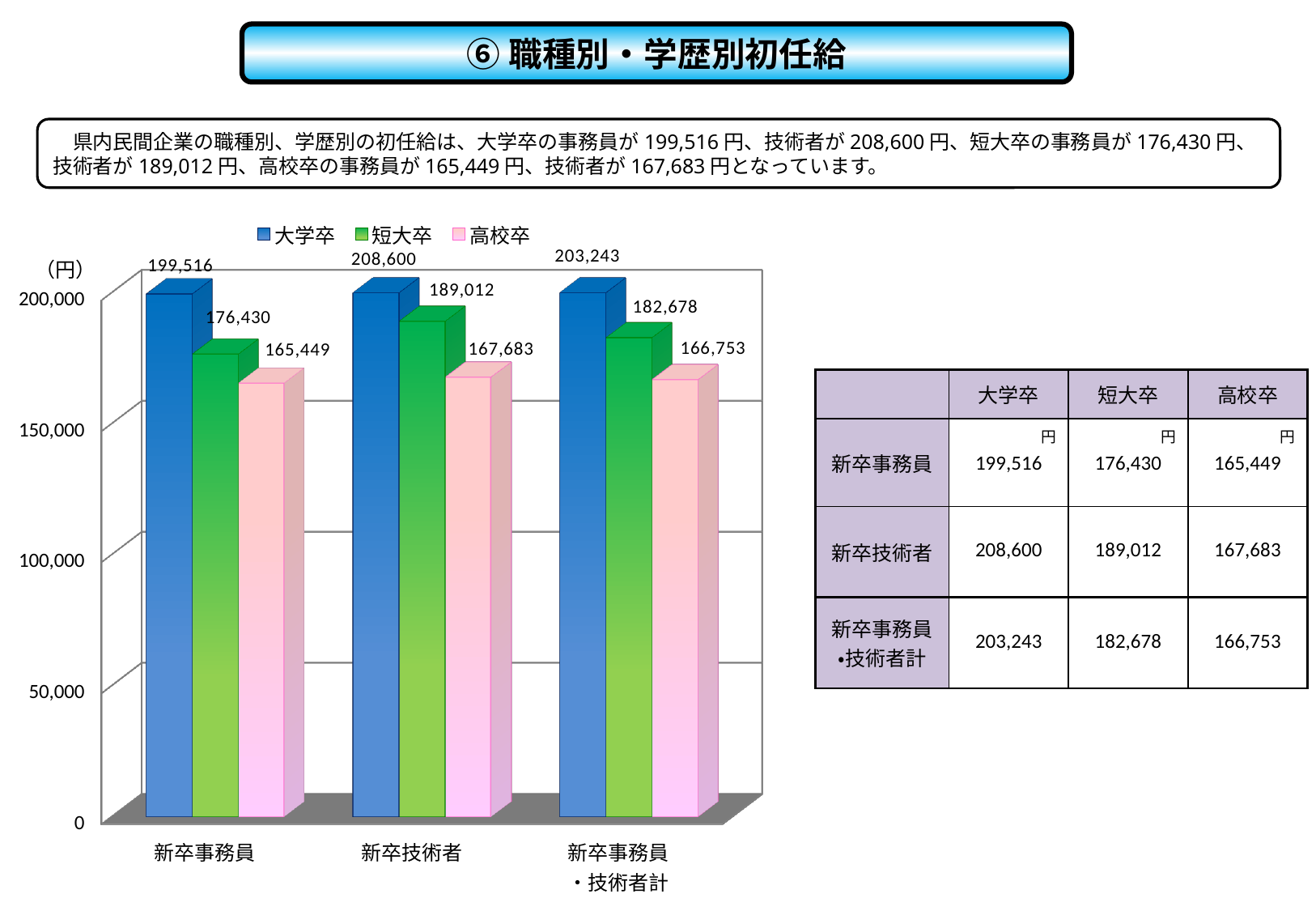
What is the difference between the 短大卒 and 高校卒 values for 新卒事務員? 10,981 Which category has the highest 大学卒 value? 新卒技術者 What is the value for 高校卒 in the 新卒事務員・技術者計 category? 166,753 What is the value for 短大卒 in the 新卒技術者 category? 189,012 Which is larger: the 高校卒 value for 新卒技術者 or the 高校卒 value for 新卒事務員・技術者計? 新卒技術者 Is the 短大卒 value for 新卒事務員 greater or less than 150,000? greater What is the value for 大学卒 in the 新卒事務員 category? 199,516 What is the difference between the 大学卒 and 短大卒 values for 新卒技術者? 19,588 How many categories are shown on the x axis? 3 Which category has the lowest 高校卒 value? 新卒事務員 What kind of chart is shown on the slide? bar chart How many series does the legend list? 3